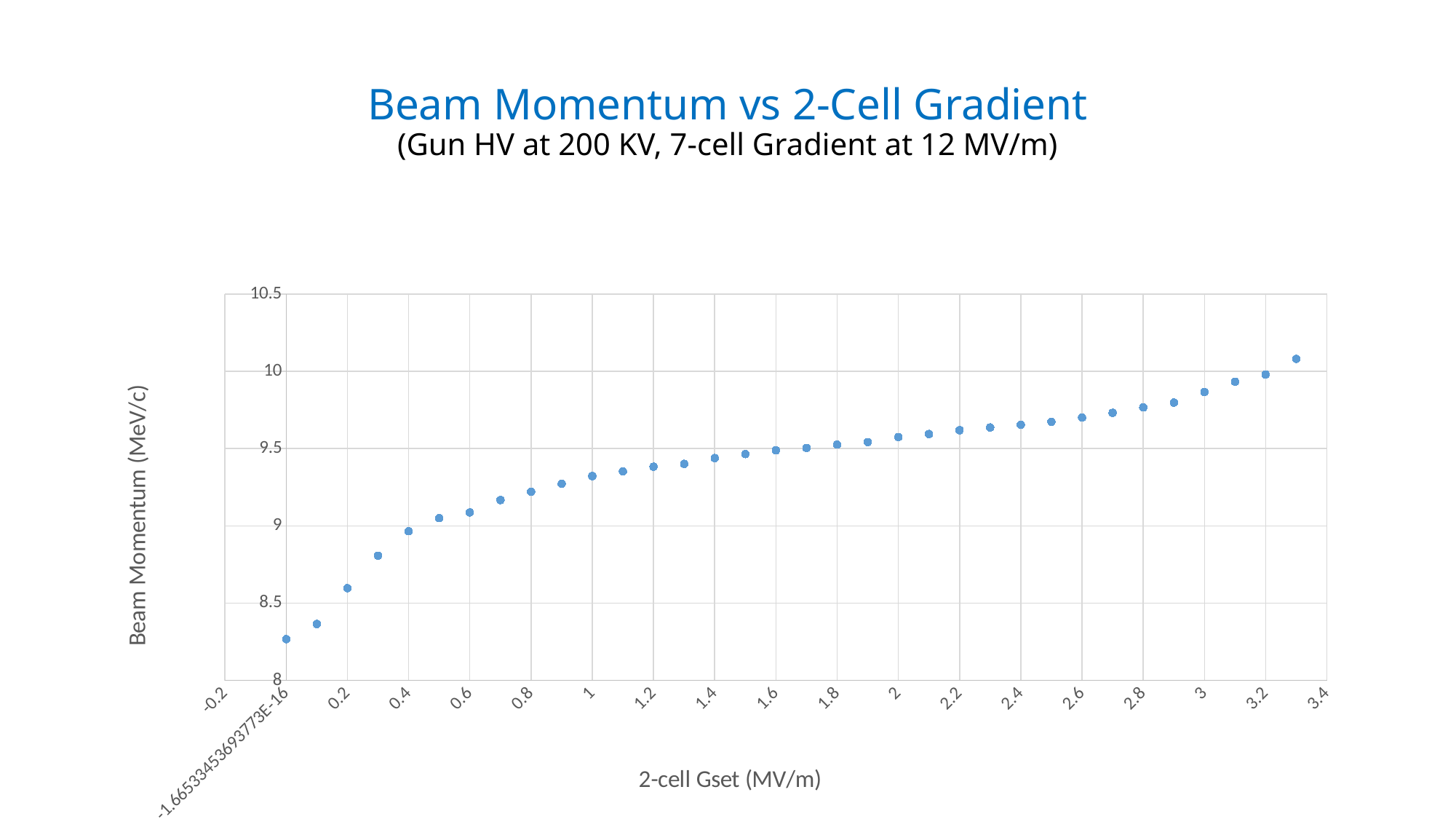
Is the beam momentum at a 2-cell Gset of 3.3 MV/m greater or less than 10? greater What is the label of the vertical axis? Beam Momentum (MeV/c) At which 2-cell Gset value is the beam momentum highest? 3.3 Does beam momentum rise or fall as the 2-cell Gset increases along the x axis? rises What is the title of the chart? Beam Momentum vs 2-Cell Gradient Which has the larger beam momentum: a 2-cell Gset of 0.2 MV/m or 2.2 MV/m? 2.2 MV/m Is the beam momentum at a 2-cell Gset of 2 MV/m greater or less than 9.5? greater How many data points are plotted on the chart? 34 What kind of chart is shown on the slide? scatter chart Is the beam momentum at a 2-cell Gset of 0.6 MV/m greater or less than 9? greater